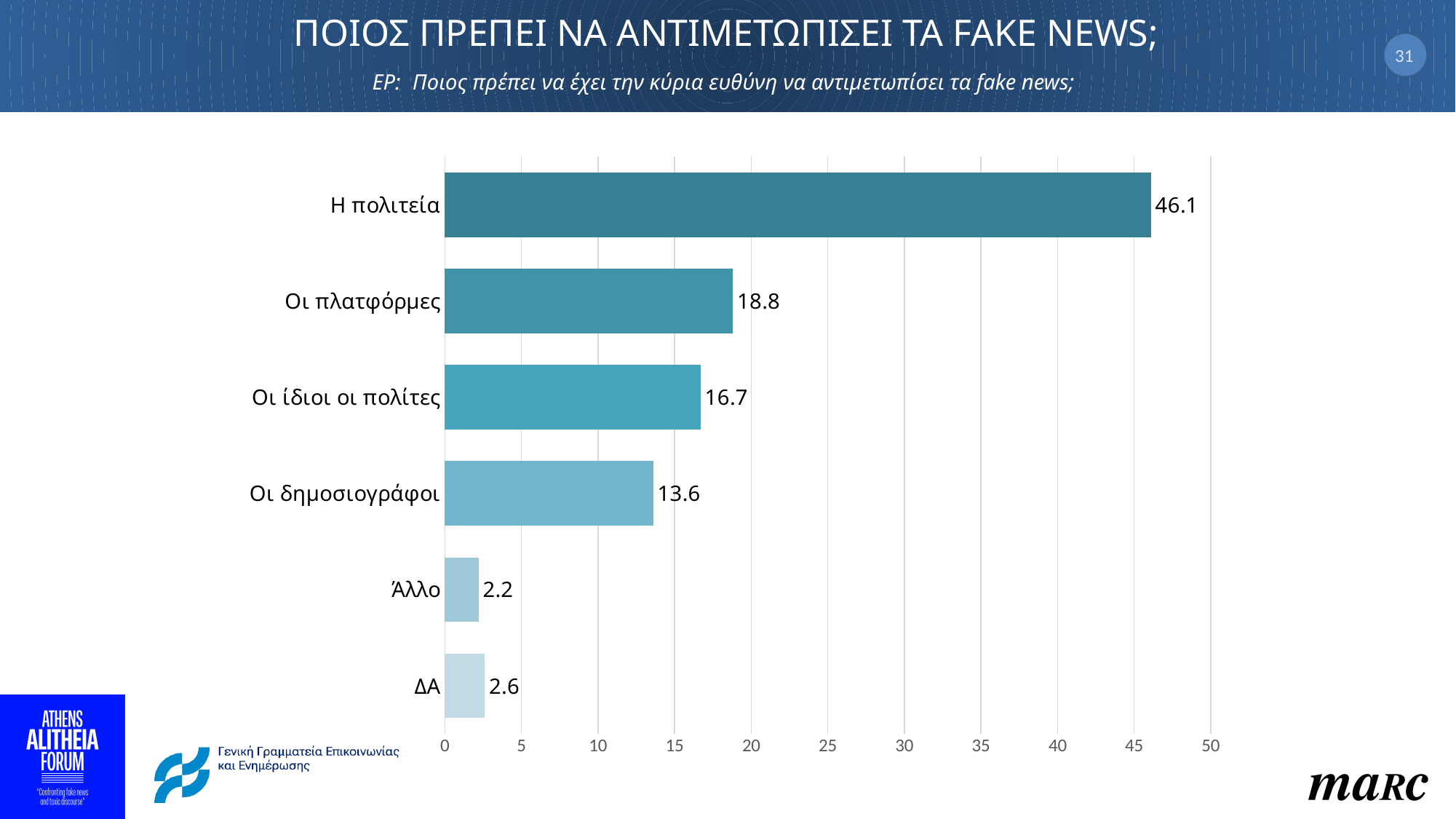
What is the difference between the values for Οι ίδιοι οι πολίτες and Οι δημοσιογράφοι? 3.1 Which is larger, the value for Οι πλατφόρμες or the value for Οι ίδιοι οι πολίτες? Οι πλατφόρμες What kind of chart is shown on the slide? bar chart What is the value for Η πολιτεία? 46.1 Is the value for Η πολιτεία greater or less than 45? greater How many categories are shown in the chart? 6 Which category has the highest value? Η πολιτεία What is the difference between the values for Η πολιτεία and Οι πλατφόρμες? 27.3 What is the value for Οι πλατφόρμες? 18.8 What is the value for Οι δημοσιογράφοι? 13.6 What is the value for ΔΑ? 2.6 Which category has the lowest value? Άλλο